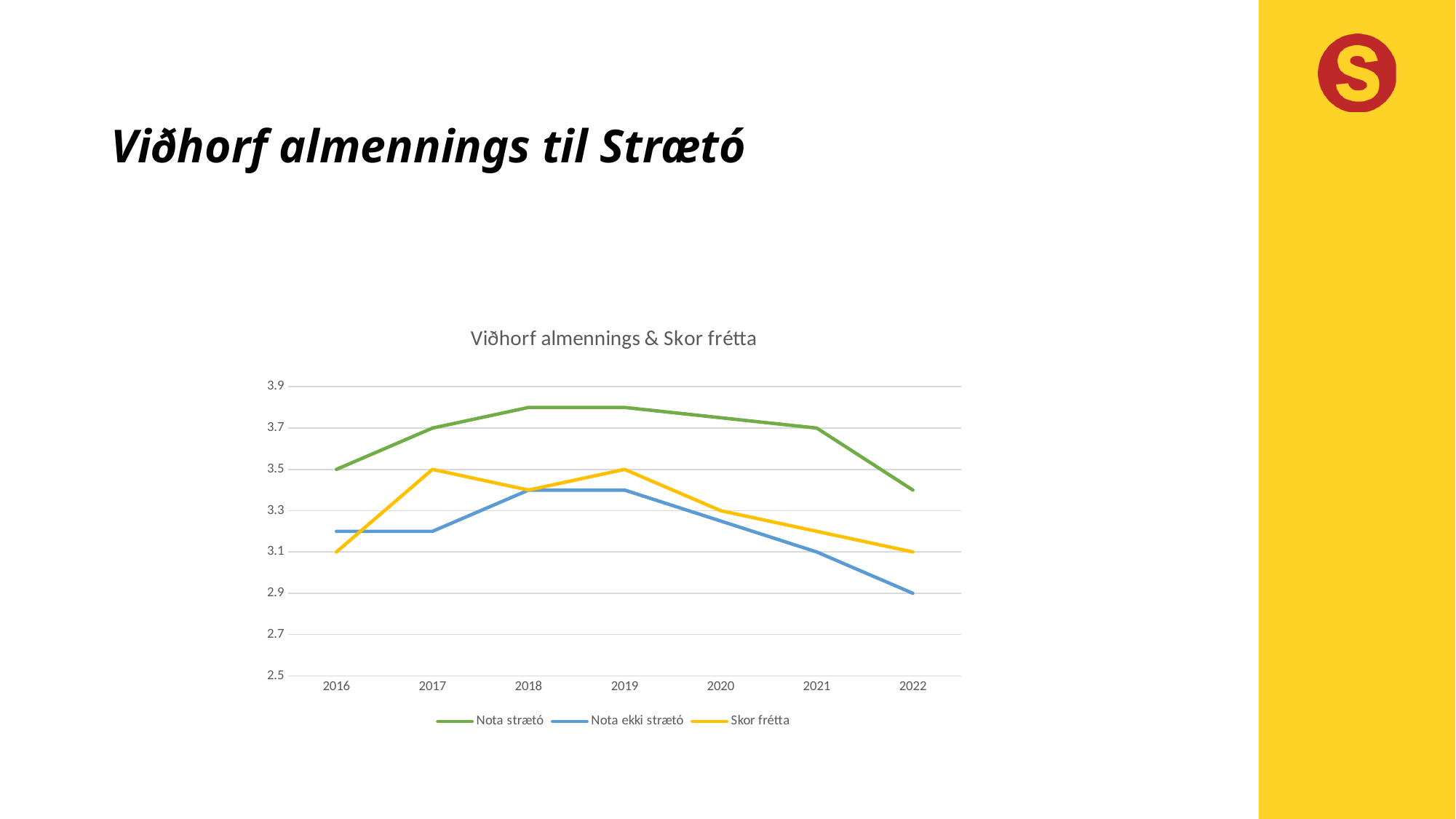
Does the Nota ekki strætó line rise or fall from 2019 to 2022? fall How many series does the legend list? 3 What is the value for Nota strætó in 2021? 3.7 What is the value for Skor frétta in 2016? 3.1 What is the value for Nota ekki strætó in 2022? 2.9 Is the value for Nota ekki strætó in 2016 greater or less than 3.3? less Is the value for Nota strætó in 2018 greater or less than 3.7? greater What is the value for Nota strætó in 2016? 3.5 What is the value for Skor frétta in 2017? 3.5 How many years are shown on the x axis? 7 Which series has the highest value in 2022? Nota strætó What kind of chart is shown on the slide? line chart